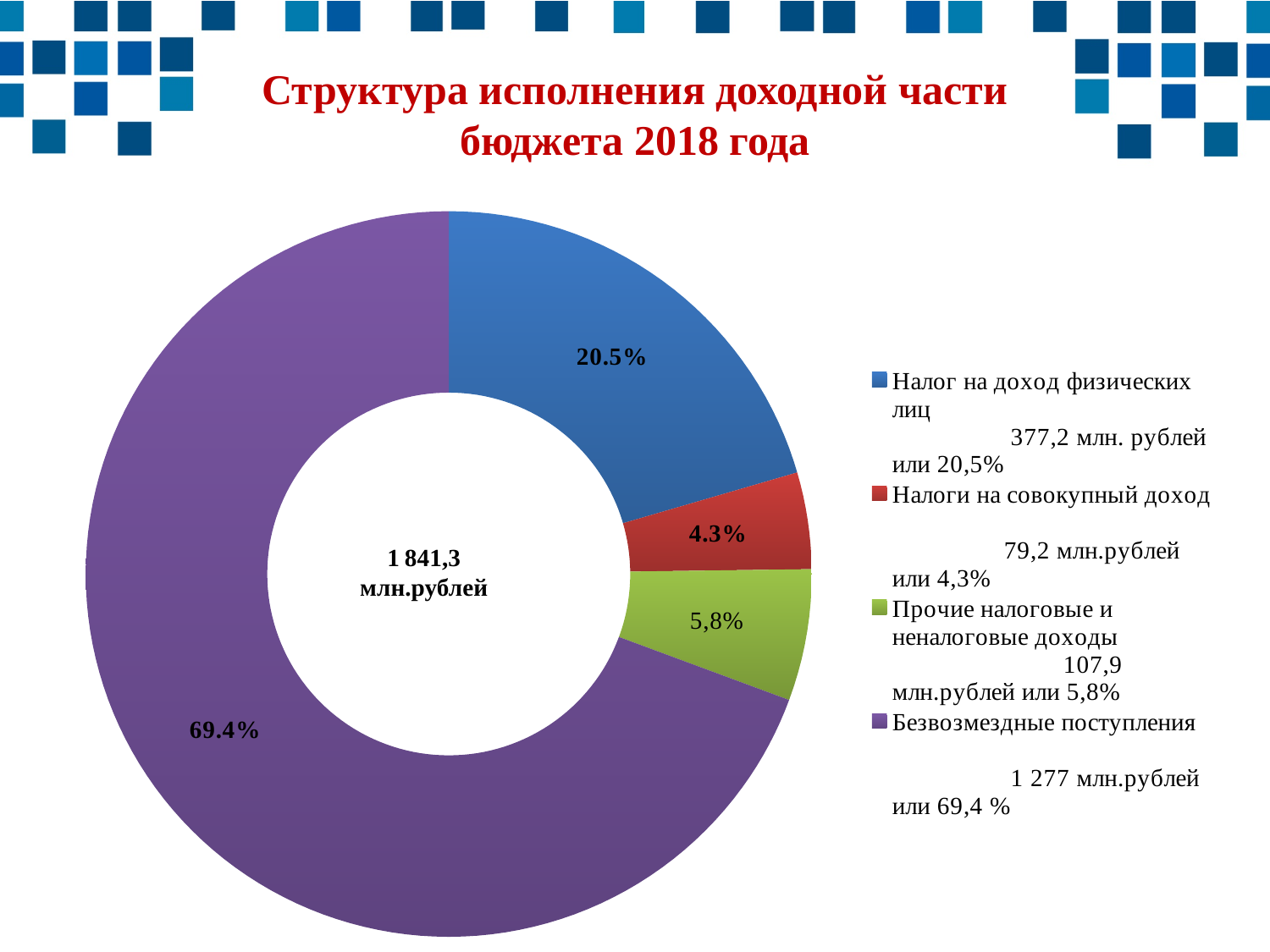
How many categories does the legend list? 4 What percentage share is shown for the slice "Прочие налоговые и неналоговые доходы"? 5,8% According to the legend, how many million rubles does "Безвозмездные поступления" amount to? 1 277 млн.рублей What percentage share is shown for the slice "Безвозмездные поступления"? 69.4% Which category has the smallest share of the chart? Налоги на совокупный доход What percentage share is shown for the slice "Налоги на совокупный доход"? 4.3% Which is larger: the share of "Налог на доход физических лиц" or the share of "Прочие налоговые и неналоговые доходы"? Налог на доход физических лиц What percentage share is shown for the slice "Налог на доход физических лиц"? 20.5% What total value is printed in the centre of the doughnut chart? 1 841,3 млн.рублей According to the legend, how many million rubles does "Налог на доход физических лиц" amount to? 377,2 млн. рублей What kind of chart is shown on the slide? Doughnut (pie) chart Which category has the largest share of the chart? Безвозмездные поступления